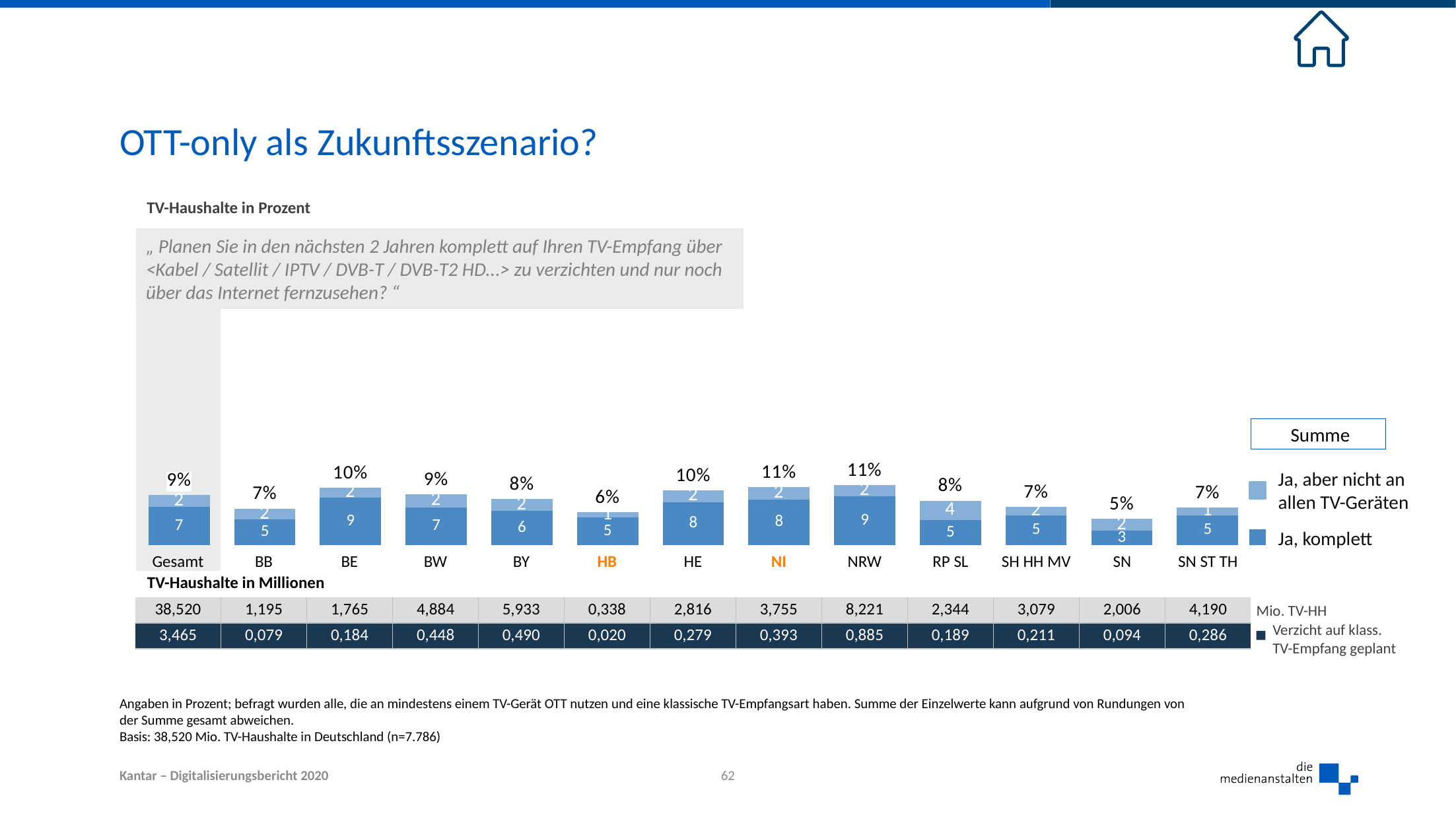
How many series does the legend list? 2 What is the 'Ja, aber nicht an allen TV-Geräten' value for RP SL? 4 Which category has the lowest 'Summe' percentage? SN What is the difference between the 'Summe' percentage for NI and the 'Summe' percentage for HB? 5% How many categories are shown on the x axis of the chart? 13 What is the 'Summe' percentage for Gesamt? 9% Is the 'Ja, komplett' value for HE larger or smaller than the 'Ja, komplett' value for BY? larger What kind of chart is shown on the slide? stacked bar chart What is the 'Ja, komplett' value for BE? 9 Which category has the highest 'Ja, komplett' value among the federal states (excluding Gesamt)? BE and NRW Which legend entry is shown in the darker blue colour? Ja, komplett What is the 'Summe' value shown above the bar for NRW? 11%